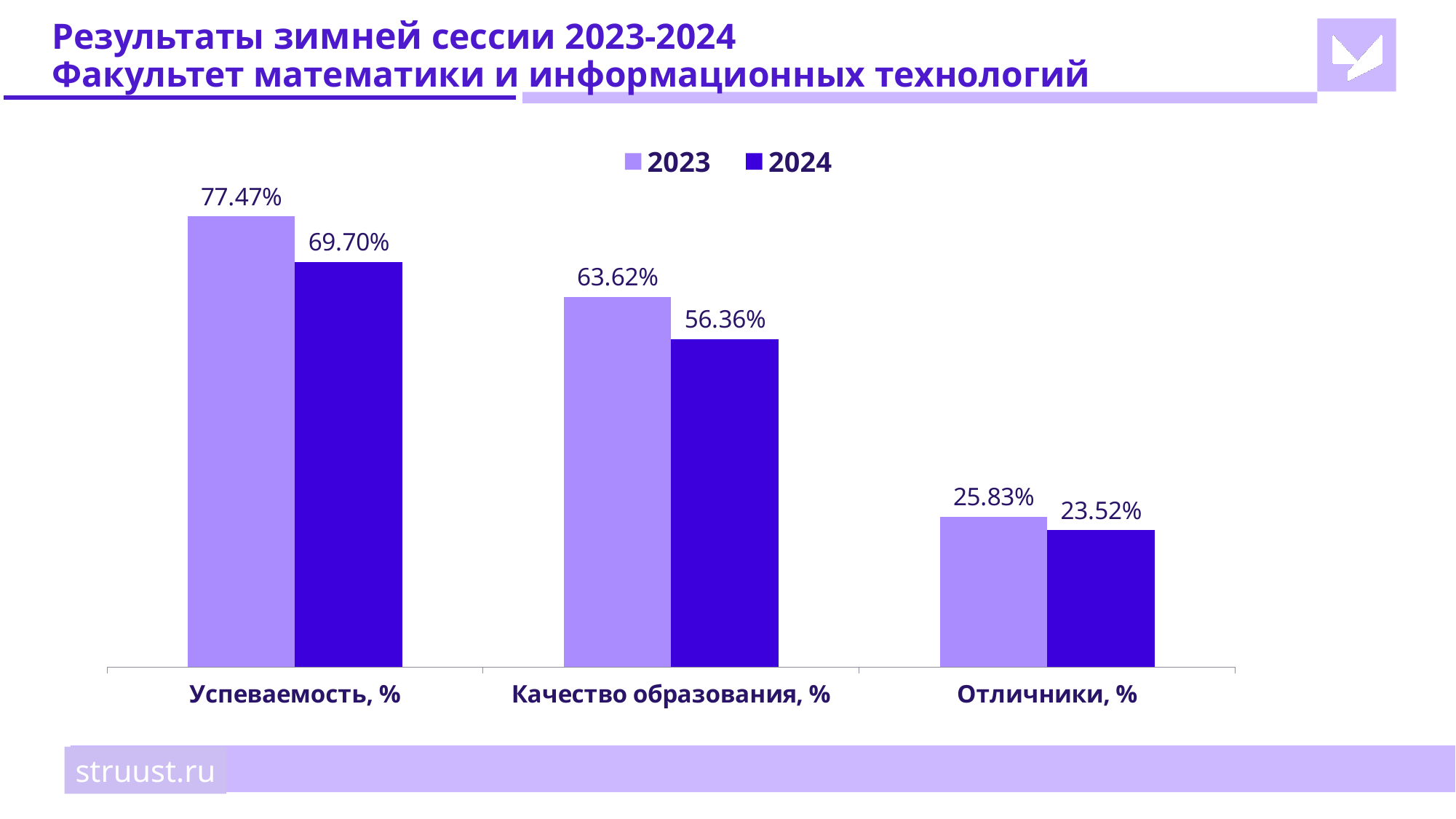
For Качество образования, %, which year has the larger value, 2023 or 2024? 2023 How many series does the legend list? 2 Which category has the lowest 2023 value? Отличники, % What kind of chart is shown on the slide? Bar chart What is the 2023 value for Качество образования, %? 63.62% What is the 2023 value for Успеваемость, %? 77.47% What is the difference between the 2023 and 2024 values for Отличники, %? 2.31% How many categories are shown on the x axis? 3 What is the 2024 value for Отличники, %? 23.52% What is the difference between the 2023 and 2024 values for Успеваемость, %? 7.77% Which category has the highest 2024 value? Успеваемость, % What is the 2024 value for Качество образования, %? 56.36%